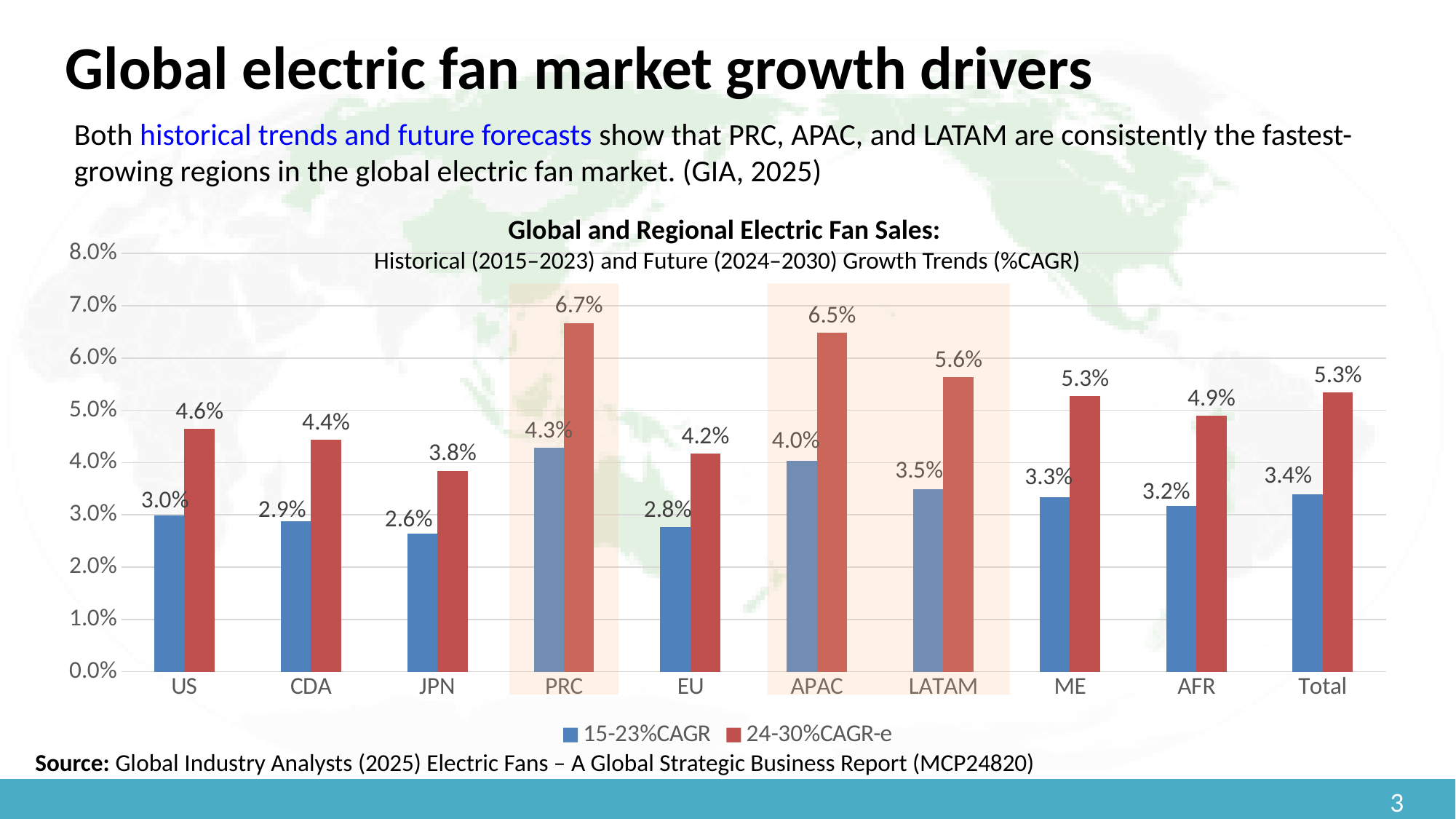
What kind of chart is shown on the slide? Bar chart Which is larger, the 24-30%CAGR-e value for ME or for AFR? ME How many categories are shown on the x axis? 10 Which region has the lowest 15-23%CAGR value? JPN What is the 24-30%CAGR-e value for LATAM? 5.6% What is the difference between the 24-30%CAGR-e and 15-23%CAGR values for APAC? 2.5% What colour are the 24-30%CAGR-e bars? Red What is the 15-23%CAGR value for PRC? 4.3% What is the 24-30%CAGR-e value for Total? 5.3% How many series does the legend list? 2 Is the 15-23%CAGR value for EU greater or less than 3.0%? less Which region has the highest 24-30%CAGR-e value? PRC